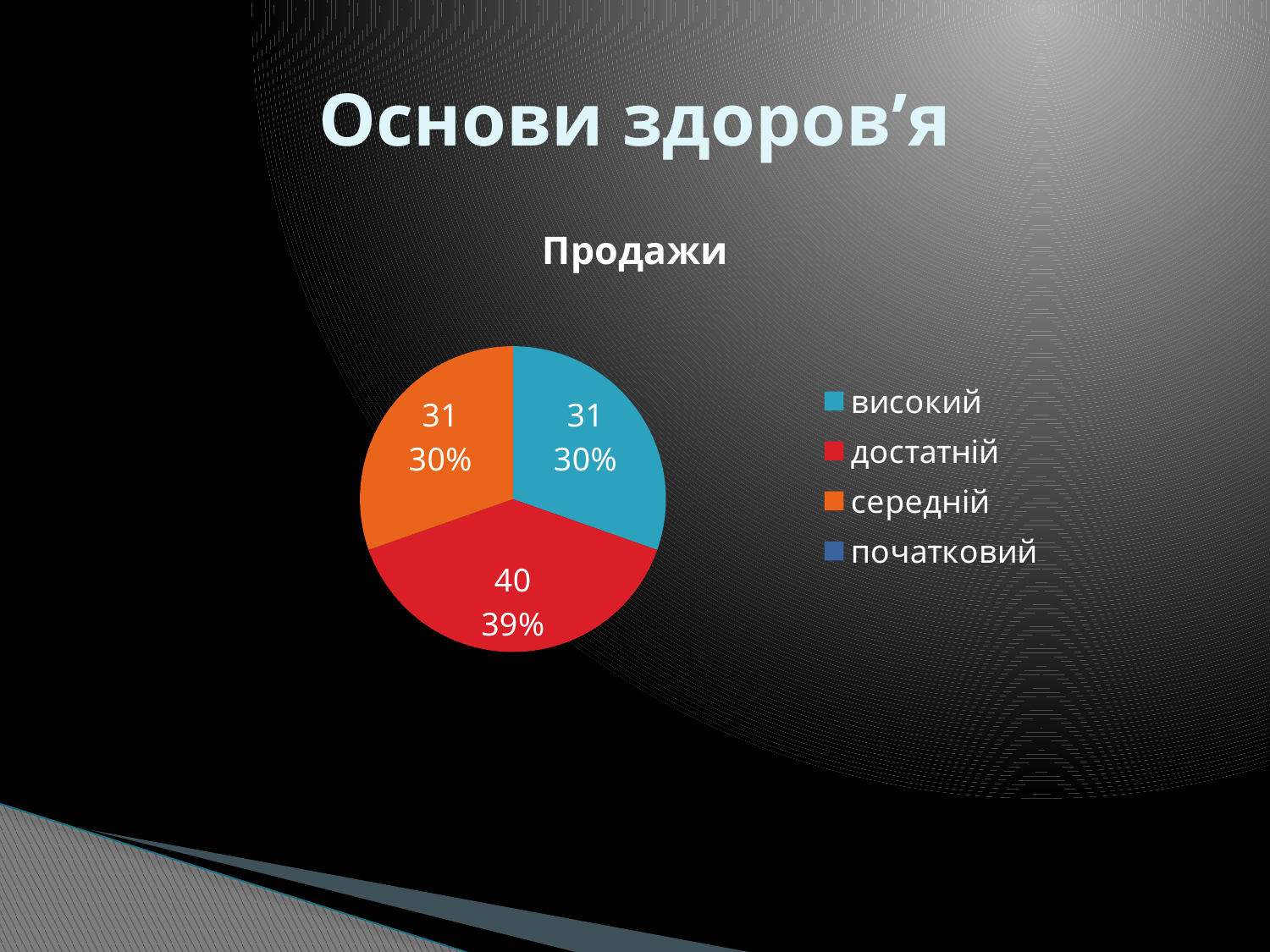
What is the value shown for the середній slice of the pie chart? 31 How many slices are visible in the pie chart? 3 What is the value shown for the високий slice of the pie chart? 31 What is the difference between the values for достатній and середній? 9 Which category has the largest slice in the pie chart? достатній What percentage share of the pie does the високий slice have? 30% What is the value shown for the достатній slice of the pie chart? 40 What percentage share of the pie does the достатній slice have? 39% What is the title of the chart? Продажи How many entries does the legend of the chart list? 4 What kind of chart is shown on the slide? pie chart Which is larger, the value for достатній or the value for високий? достатній